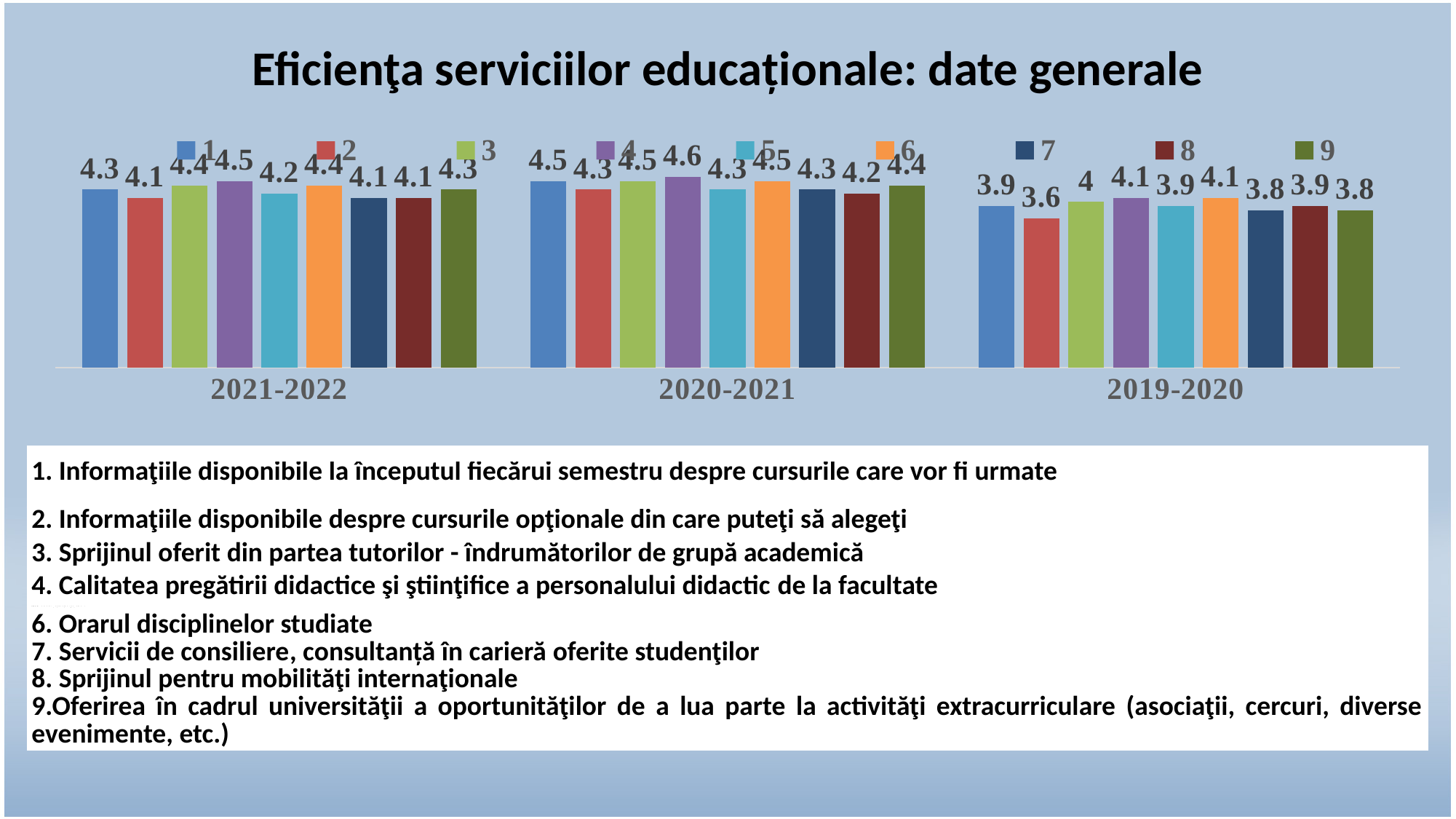
What is the difference between the value for series 4 and the value for series 2 in 2019-2020? 0.5 What type of chart is shown on the slide? bar chart What is the value for series 2 in 2019-2020? 3.6 Which is larger: the value for series 1 in 2020-2021 or the value for series 1 in 2019-2020? 2020-2021 Which series has the lowest value in 2019-2020? 2 What is the title of the chart? Eficienţa serviciilor educaționale: date generale What is the value for series 9 in 2021-2022? 4.3 Does the value for series 3 rise or fall from 2020-2021 to 2019-2020? fall How many series does the legend list? 9 Which series has the highest value in 2021-2022? 4 What is the value for series 4 in 2020-2021? 4.6 How many year categories are shown on the x axis? 3